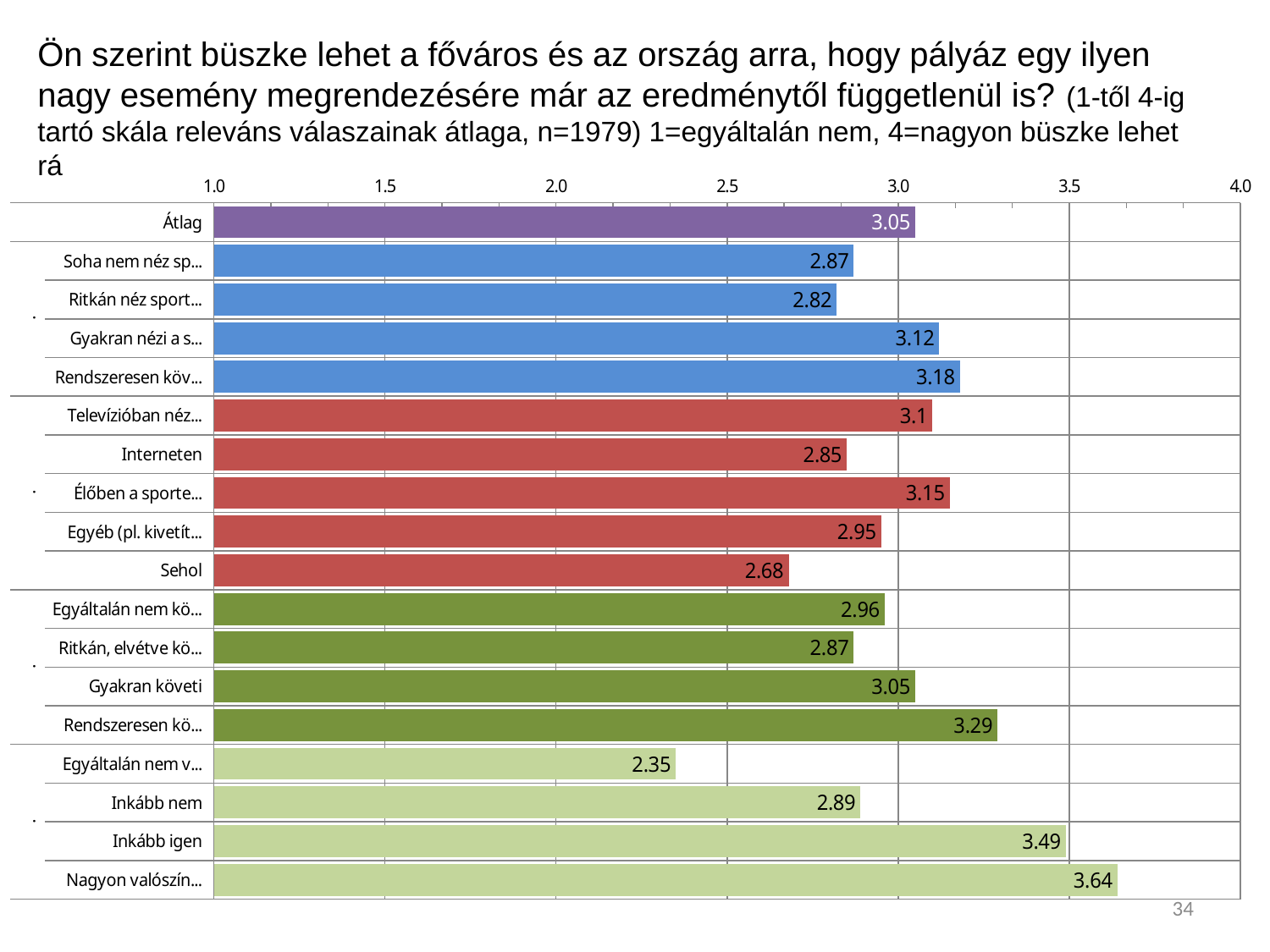
What kind of chart is shown on the slide? bar chart Which category has the highest value? Nagyon valószín… What colour is the bar for Átlag? purple How many bars are plotted in the chart? 18 What is the value for Interneten? 2.85 What is the value for Inkább igen? 3.49 Is the value for Sehol greater or less than 3.0? less What is the value for Sehol? 2.68 Which is larger, the value for Gyakran követi or the value for Interneten? Gyakran követi What is the difference between the values for Inkább igen and Inkább nem? 0.6 Which category has the lowest value? Egyáltalán nem v… What is the value for Átlag? 3.05